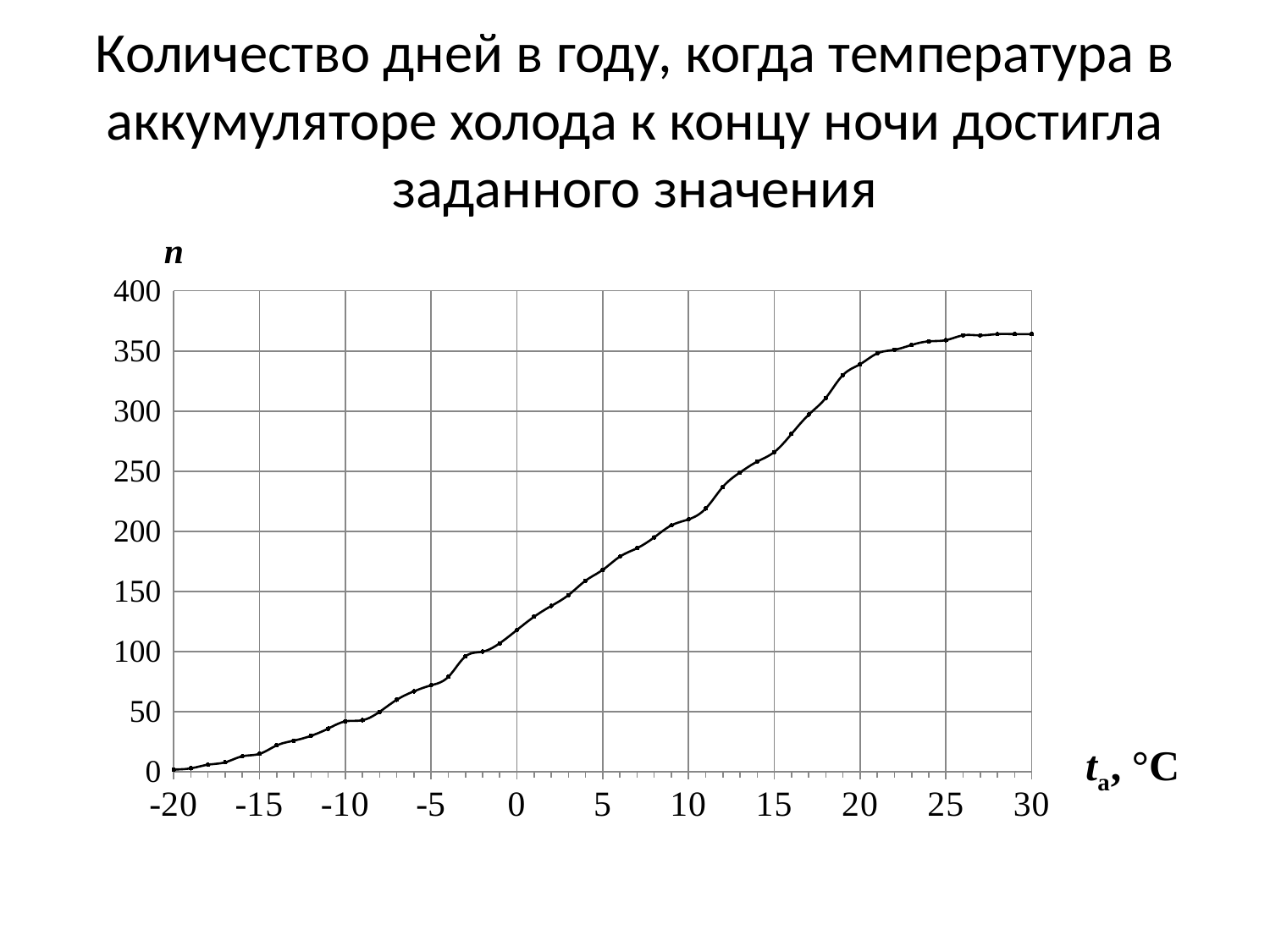
What is the label of the vertical axis? n Is the value of n at t_a = 0 °C greater or less than 100? greater What kind of chart is shown on the slide? line chart Is the value of n at t_a = -5 °C greater or less than 100? less Is the value of n at t_a = 30 °C greater or less than 350? greater At which temperature on the x axis is the value of n lowest? -20 °C Do the values of n rise or fall as the temperature t_a increases from -20 to 30 °C? rise